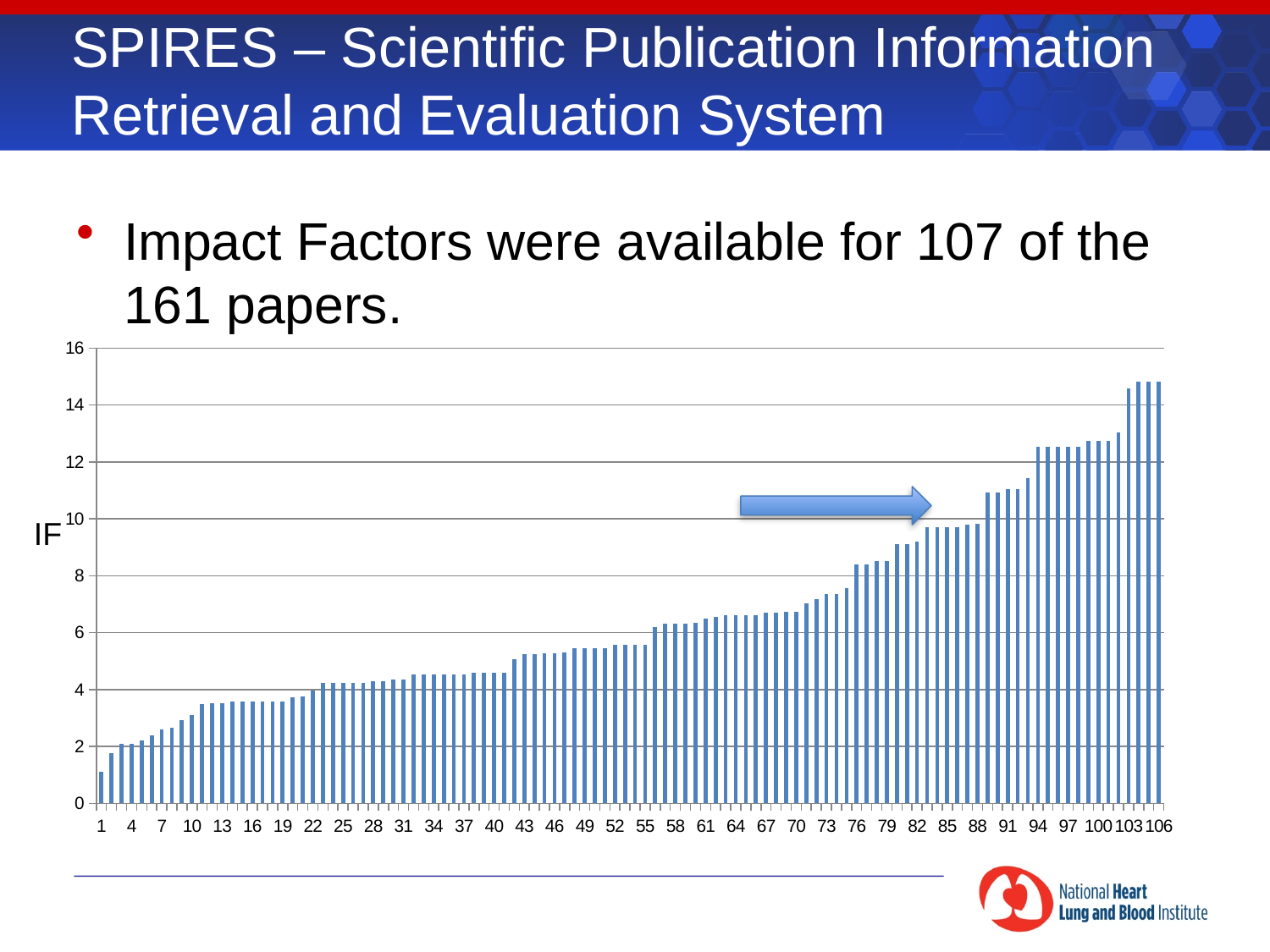
Is the value for bar 76 greater or less than 8? greater Is the value for bar 91 greater or less than 10? greater Is the value for bar 106 greater or less than 14? greater Do the bar values rise or fall as you move from left to right along the x axis? rise What kind of chart is shown on the slide? bar chart Which bar has the lowest value on the chart? 1 Which is larger, the value for bar 40 or the value for bar 100? bar 100 What label is shown on the vertical axis of the chart? IF